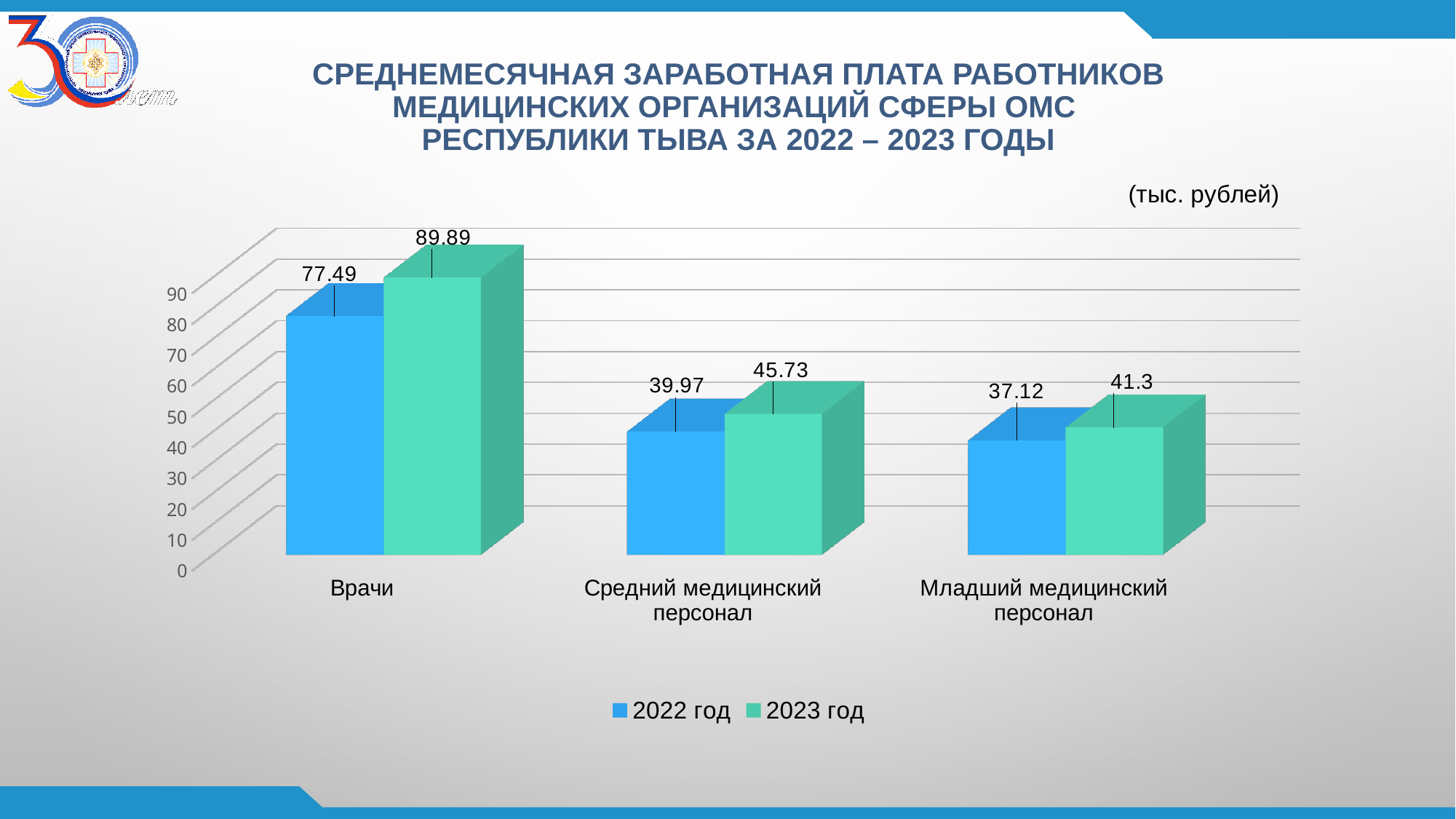
What was the average monthly salary for Средний медицинский персонал in 2022 год? 39.97 What unit is indicated for the values on the chart? тыс. рублей What was the average monthly salary for Врачи in 2023 год? 89.89 Which category has the lowest value in 2023 год? Младший медицинский персонал How many series does the legend list? 2 Which category has the highest value in 2022 год? Врачи What kind of chart is shown on the slide? Bar chart What was the average monthly salary for Младший медицинский персонал in 2023 год? 41.3 What is the difference between the 2023 год and 2022 год values for Врачи? 12.4 How many categories are shown on the x axis? 3 Which is larger: the 2022 год value for Средний медицинский персонал or the 2022 год value for Младший медицинский персонал? Средний медицинский персонал What is the difference between the 2023 год and 2022 год values for Средний медицинский персонал? 5.76